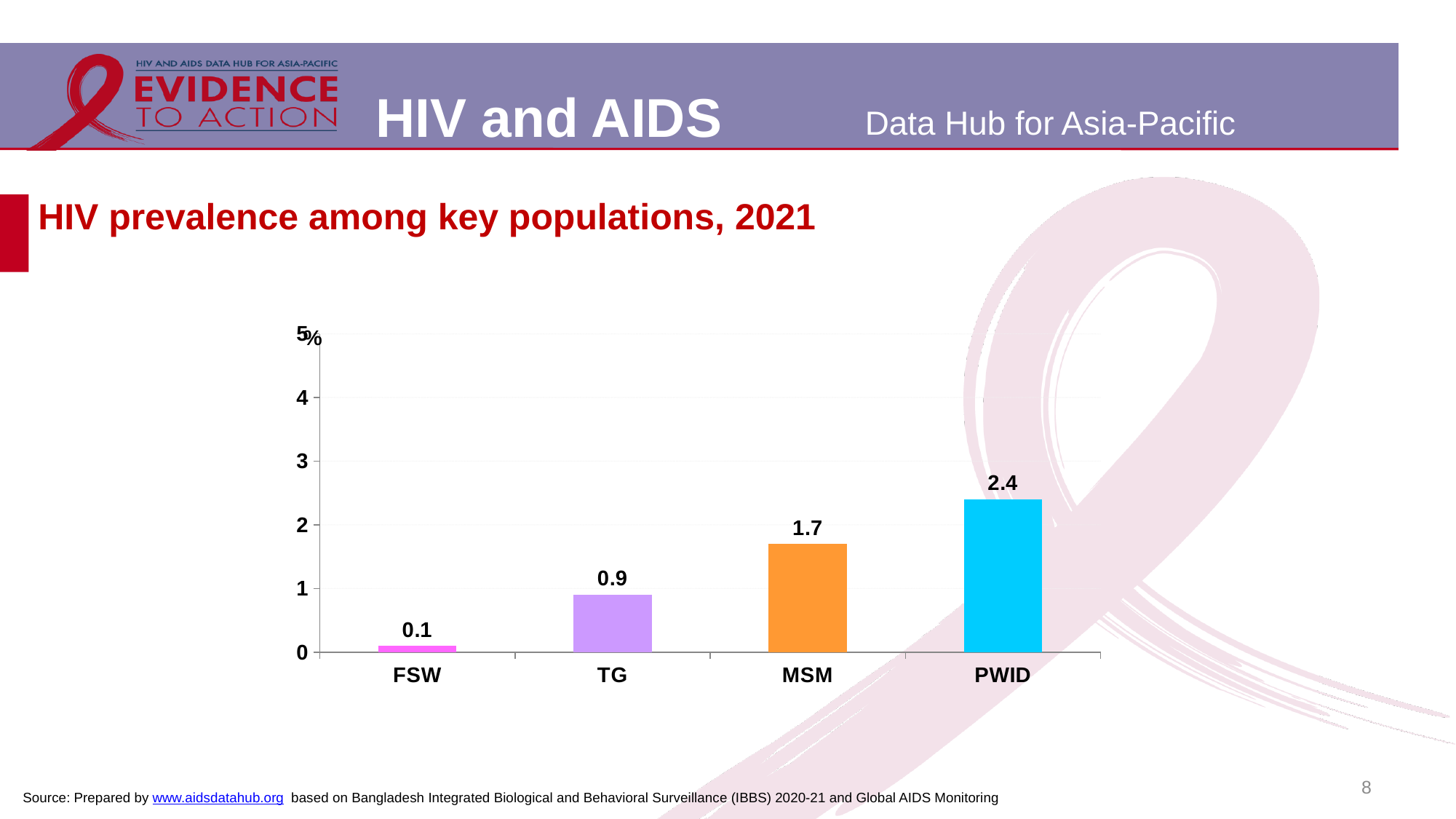
What kind of chart is shown on the slide? Bar chart Do the values rise or fall from FSW to PWID along the x axis? Rise What is the HIV prevalence among PWID? 2.4 Which key population has the highest HIV prevalence? PWID What is the HIV prevalence among FSW? 0.1 Which key population has the lowest HIV prevalence? FSW What is the HIV prevalence among TG? 0.9 How many key populations are shown in the chart? 4 What is the difference in HIV prevalence between PWID and MSM? 0.7 What is the HIV prevalence among MSM? 1.7 Is the value for PWID greater or less than 2? greater Which has a higher HIV prevalence, TG or MSM? MSM